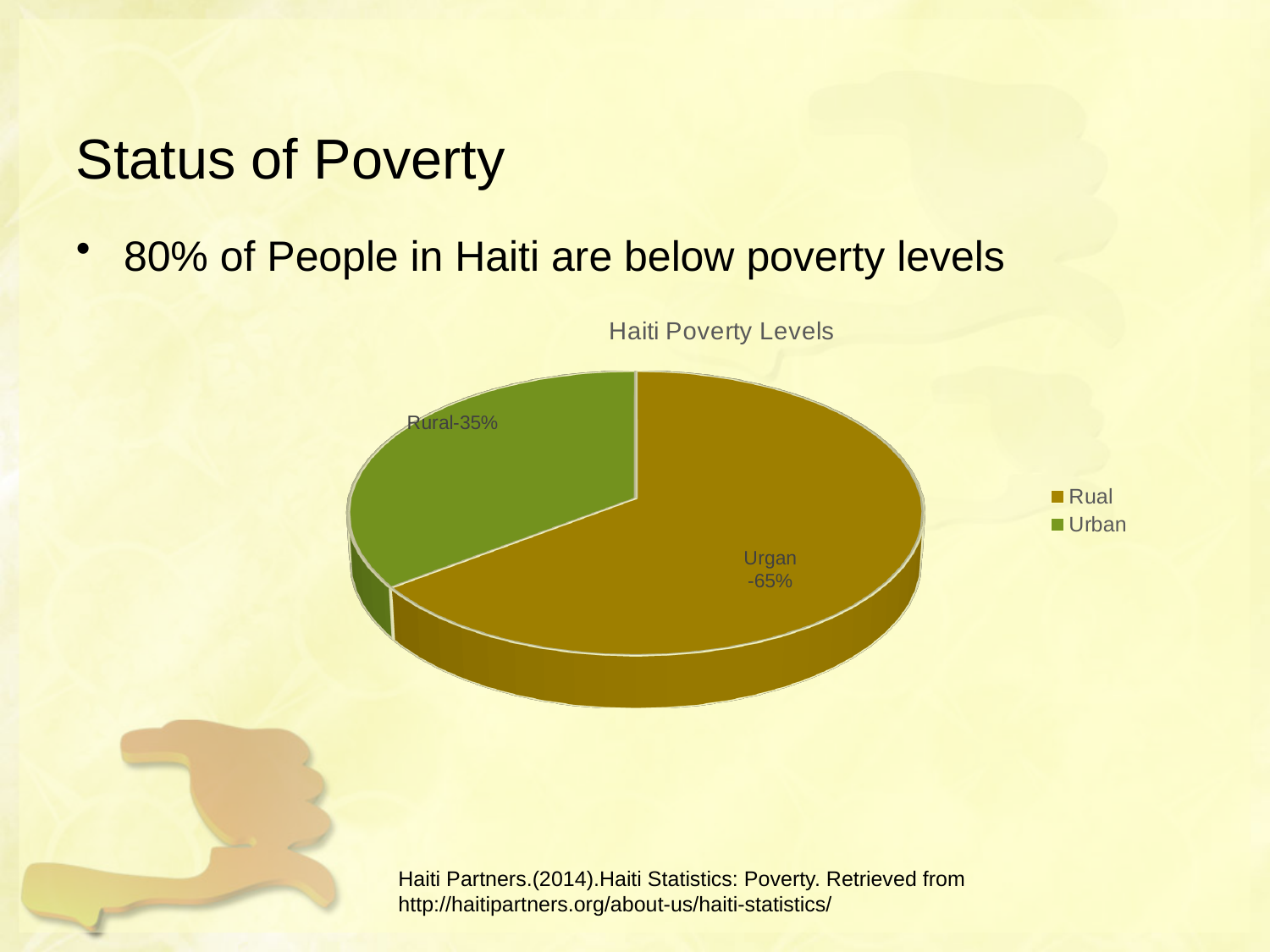
What is the difference between the 65% slice and the 35% slice? 30% What percentage is printed on the slice labelled Urgan? 65% What type of chart is shown on the slide? pie chart Is the percentage on the Rural slice greater or less than 50%? less What is the title of the chart? Haiti Poverty Levels What share of the pie does the green slice represent? 35% Which slice label shows the larger percentage, Rural or Urgan? Urgan How many slices does the pie chart have? 2 Which slice has the smallest share of the pie? Rural-35% What percentage is printed on the slice labelled Rural? 35% How many entries does the chart legend list? 2 What colour is the slice labelled Urgan -65%? gold